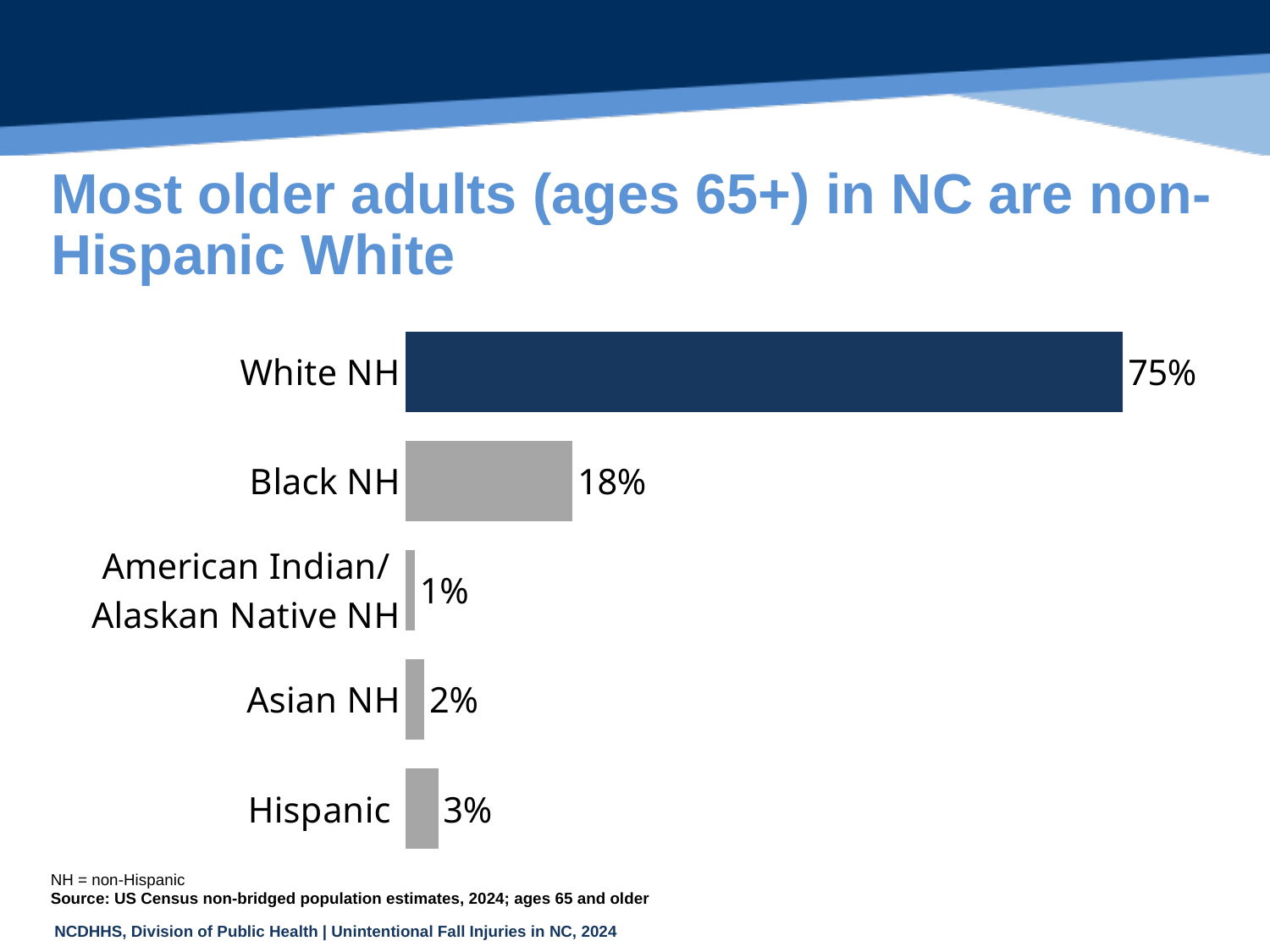
What type of chart is shown on the slide? Bar chart Which bar is coloured dark blue rather than grey? White NH What is the difference in percentage points between White NH and Black NH? 57 Which is larger, the percentage for Hispanic or for Asian NH? Hispanic What percentage of older adults in NC are White NH? 75% What percentage of older adults in NC are American Indian/Alaskan Native NH? 1% What percentage of older adults in NC are Black NH? 18% How many categories are shown in the chart? 5 Which category has the highest percentage? White NH Which category has the lowest percentage? American Indian/Alaskan Native NH What percentage of older adults in NC are Asian NH? 2% What percentage of older adults in NC are Hispanic? 3%